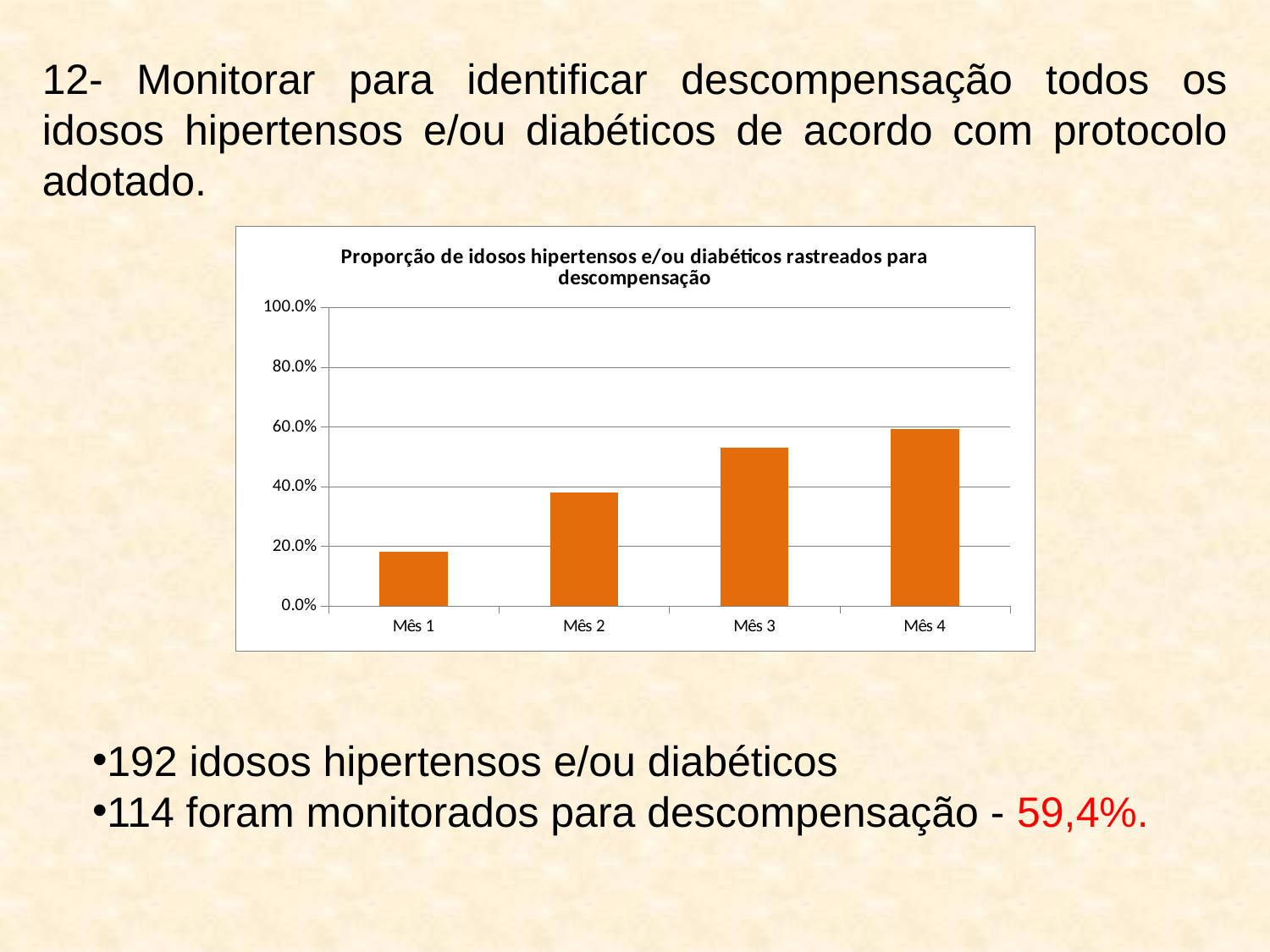
Which month has the highest proportion of elderly hypertensive and/or diabetic patients screened for decompensation? Mês 4 What kind of chart is shown on the slide? bar chart Is the value for Mês 1 greater or less than 20.0%? less Is the value for Mês 3 greater or less than 40.0%? greater Is the value for Mês 2 greater or less than 40.0%? less How many categories (months) are plotted on the chart? 4 Do the values rise or fall from Mês 1 to Mês 4? rise What is the title of the chart? Proporção de idosos hipertensos e/ou diabéticos rastreados para descompensação What is the maximum value shown on the vertical axis of the chart? 100.0% Which month has the lowest proportion of elderly hypertensive and/or diabetic patients screened for decompensation? Mês 1 Which is larger, the value for Mês 2 or the value for Mês 3? Mês 3